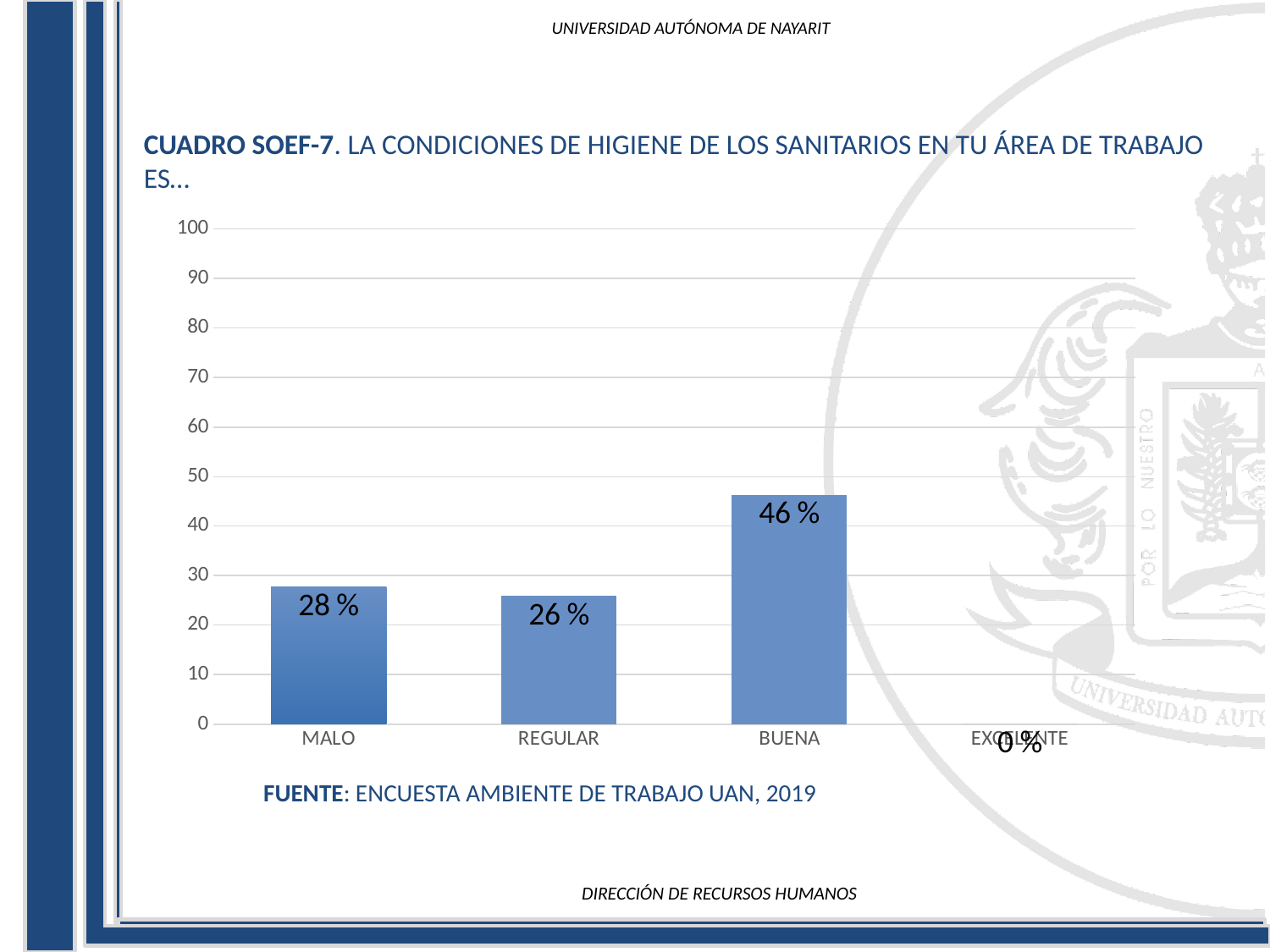
What source is cited below the chart? ENCUESTA AMBIENTE DE TRABAJO UAN, 2019 Is the value for BUENA greater or less than 40? greater Which category has the lowest value? EXCELENTE What is the value for BUENA? 46 % Which is larger, the value for MALO or the value for REGULAR? MALO How many categories are shown on the x axis? 4 What is the value for MALO? 28 % What is the value for REGULAR? 26 % What is the value for EXCELENTE? 0 % Which category has the highest value? BUENA What kind of chart is shown on the slide? bar chart What is the difference between the values for BUENA and MALO? 18 %